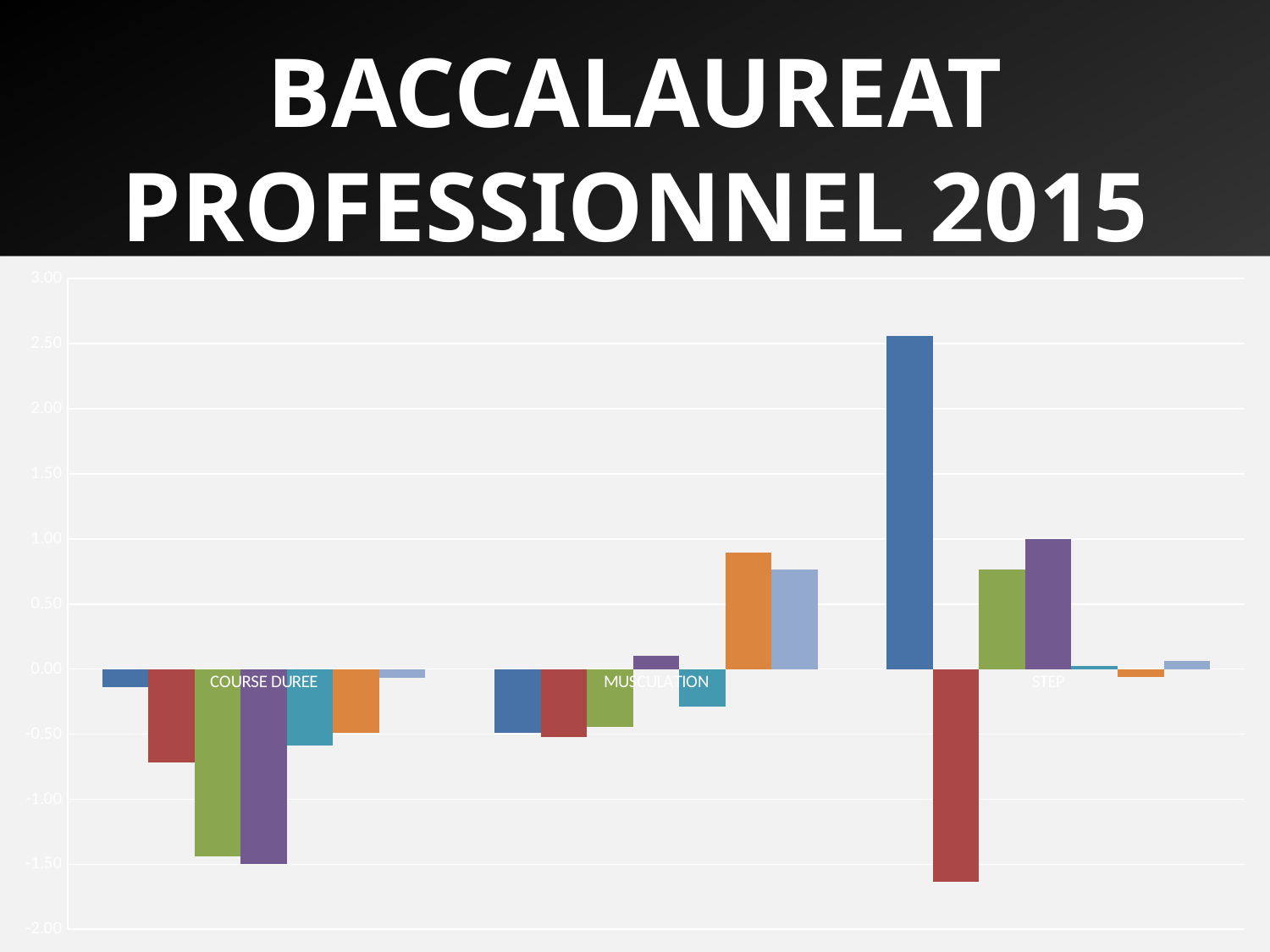
How many bars are plotted for each category in the chart? 7 In the STEP category, which is taller, the blue bar or the purple bar? blue bar Is the value of the lowest bar in the STEP category greater or less than -1.50? less Is the value of the green bar in the COURSE DUREE category greater or less than -1.00? less Is the value of the tallest bar in the STEP category greater or less than 2.00? greater Which category contains the lowest bar in the chart? STEP In the COURSE DUREE category, which is lower, the red bar or the green bar? green bar What is the title shown on the slide above the chart? BACCALAUREAT PROFESSIONNEL 2015 What kind of chart is shown on the slide? bar chart Which category contains the highest bar in the chart? STEP How many categories are shown on the x axis of the chart? 3